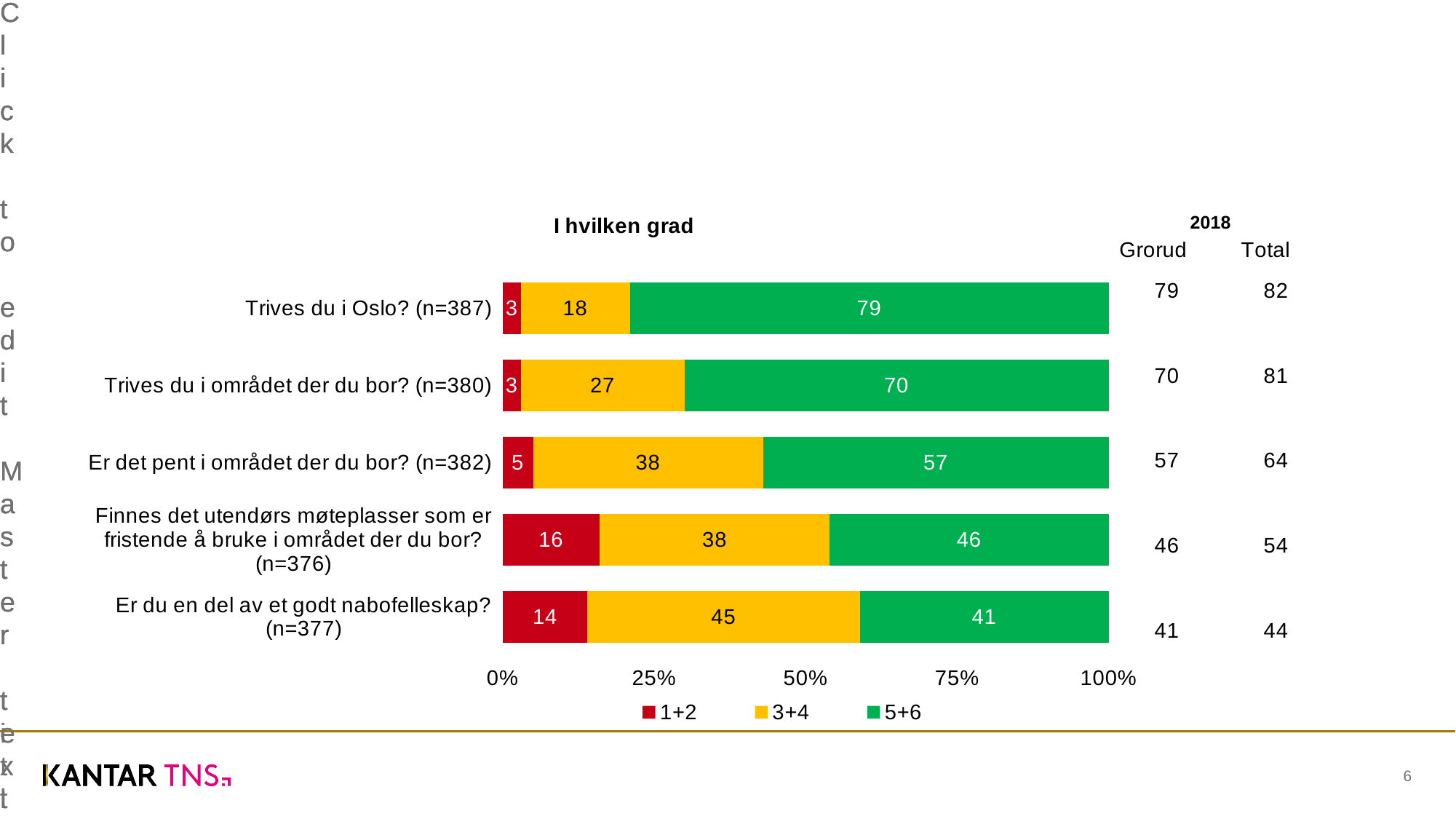
Which category has the lowest 5+6 value? Er du en del av et godt nabofelleskap? (n=377) Which category has the highest 5+6 value? Trives du i Oslo? (n=387) What is the title of the chart? I hvilken grad How many series does the legend list? 3 How many questions (categories) are plotted in the chart? 5 What kind of chart is shown on the slide? Stacked bar chart Which is larger: the 3+4 value for "Er du en del av et godt nabofelleskap? (n=377)" or the 3+4 value for "Er det pent i området der du bor? (n=382)"? Er du en del av et godt nabofelleskap? (n=377) What is the 3+4 value for "Trives du i området der du bor? (n=380)"? 27 What is the difference between the 5+6 values for "Trives du i Oslo? (n=387)" and "Trives du i området der du bor? (n=380)"? 9 Which colour represents the 1+2 series in the legend? Red What is the 1+2 value for "Finnes det utendørs møteplasser som er fristende å bruke i området der du bor? (n=376)"? 16 What is the 5+6 value for "Trives du i Oslo? (n=387)"? 79